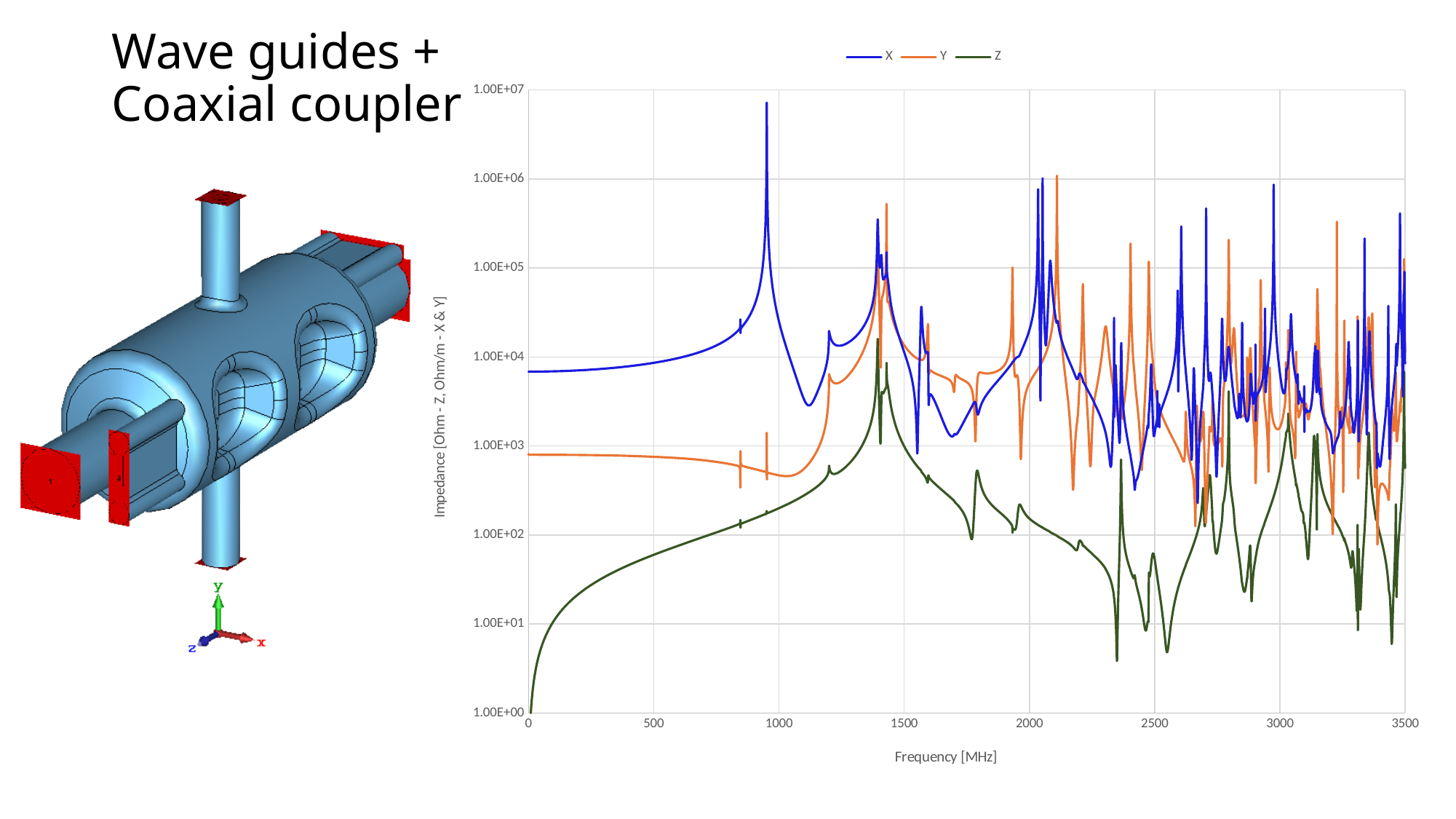
Which series reaches the highest peak on the chart? X Is the value of the Z series at 1000 MHz greater or less than 1.00E+03? less What is the label of the x axis? Frequency [MHz] What are the names of the series in the legend? X, Y, Z Is the value of the X series at 500 MHz greater or less than 1.00E+04? less What kind of chart is shown on the slide? line chart Which series has the lowest values between 0 and 500 MHz? Z Is the value of the Y series at 500 MHz greater or less than 1.00E+03? less How many series does the legend list? 3 What is the highest frequency tick shown on the x axis? 3500 At 500 MHz, which series has the larger value, X or Z? X